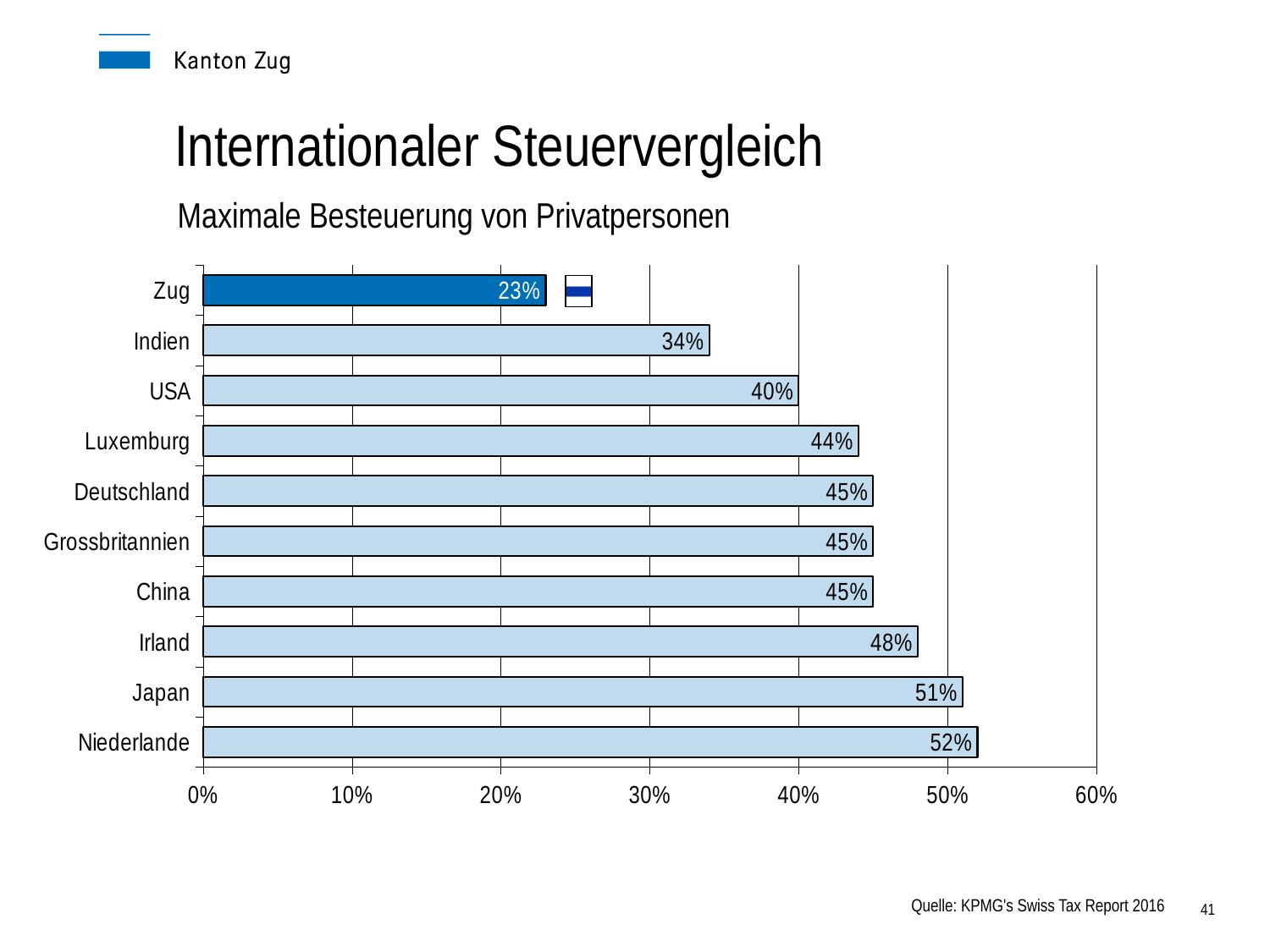
What is the difference between the values for Niederlande and Zug? 29% Which is larger, the value for Indien or the value for USA? USA What is the value for Luxemburg? 44% What kind of chart is shown on the slide? bar chart What is the value for Japan? 51% Which category has the highest value? Niederlande What is the subtitle of the chart? Maximale Besteuerung von Privatpersonen Which category has the lowest value? Zug Is the value for Japan greater or less than 50%? greater What is the difference between the values for Irland and USA? 8% What is the value for Zug? 23% How many categories are shown in the chart? 10